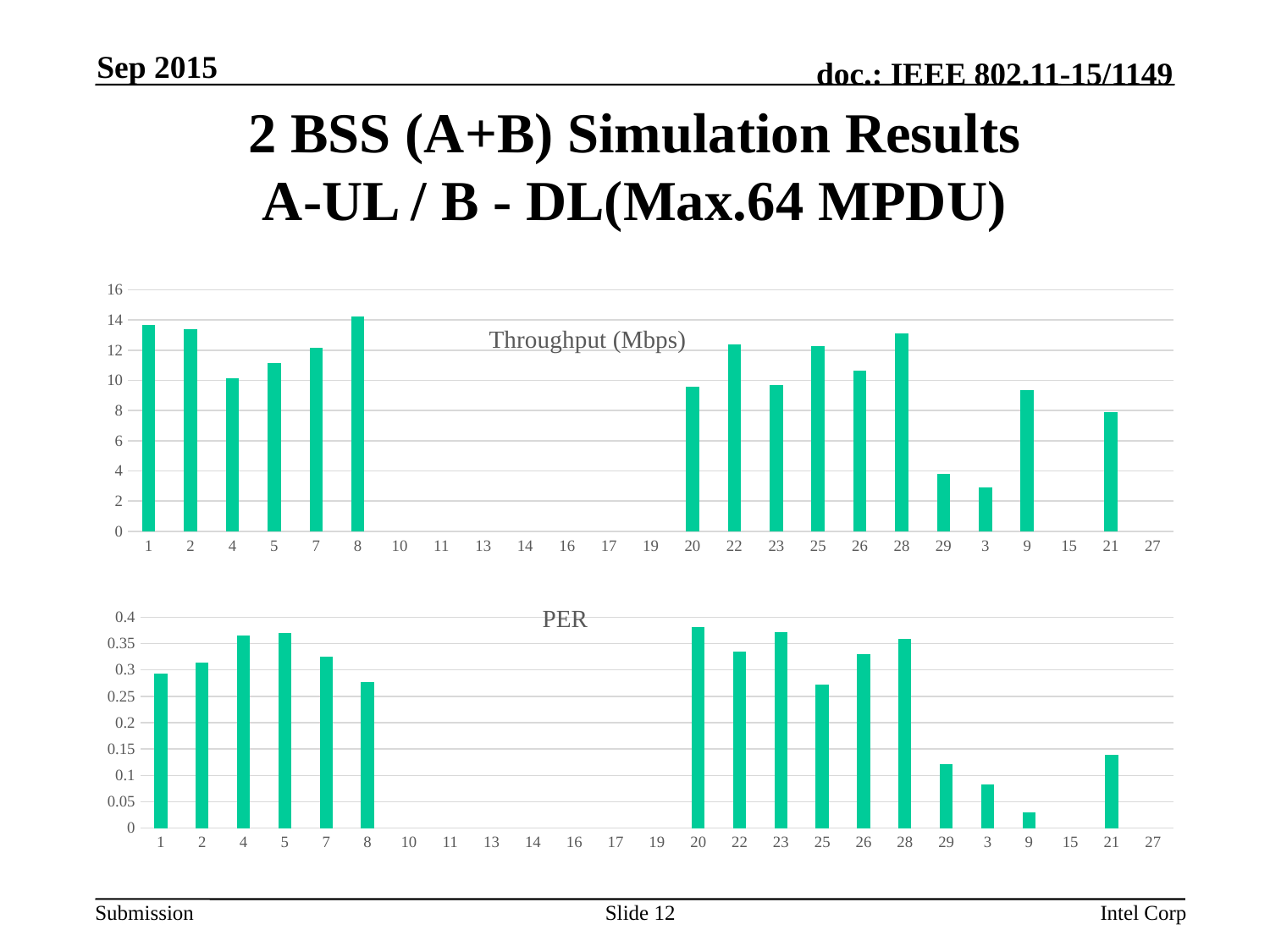
What is the title of the lower chart on the slide? PER In the PER chart, is the value for category 9 greater or less than 0.05? less In the Throughput (Mbps) chart, is the value for category 1 greater or less than 12? greater In the Throughput (Mbps) chart, which has the larger value, category 1 or category 4? 1 What type of chart is the Throughput (Mbps) chart? bar chart In the Throughput (Mbps) chart, which category has the highest throughput? 8 How many categories are shown on the x axis of the Throughput (Mbps) chart? 25 In the PER chart, which has the larger value, category 4 or category 8? 4 In the Throughput (Mbps) chart, which category has the lowest non-zero throughput? 3 In the PER chart, which category has the lowest non-zero PER? 9 In the PER chart, is the value for category 20 greater or less than 0.35? greater